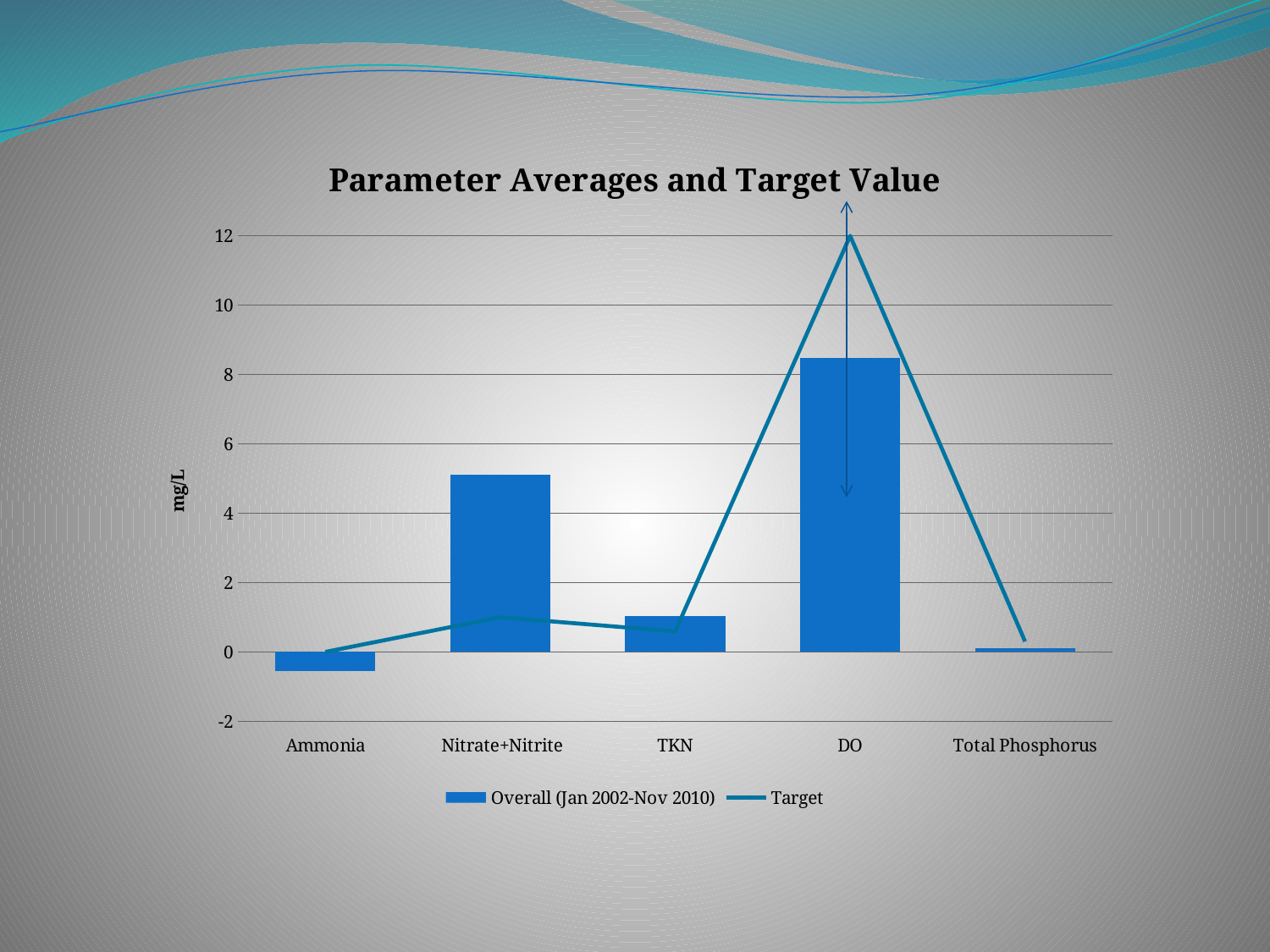
Which category has the lowest Overall (Jan 2002-Nov 2010) bar? Ammonia What type of chart is shown on the slide? Bar chart with a line series What is the label on the y axis of the chart? mg/L What is the title of the chart? Parameter Averages and Target Value Which category has the highest Overall (Jan 2002-Nov 2010) bar? DO How many categories are shown on the x axis of the chart? 5 Is the Overall (Jan 2002-Nov 2010) value for TKN greater or less than 2? less How many series does the legend list? 2 Which has the larger Overall (Jan 2002-Nov 2010) bar, Nitrate+Nitrite or TKN? Nitrate+Nitrite Is the Overall (Jan 2002-Nov 2010) value for Nitrate+Nitrite greater or less than 4? greater Is the Overall (Jan 2002-Nov 2010) value for DO greater or less than 8? greater